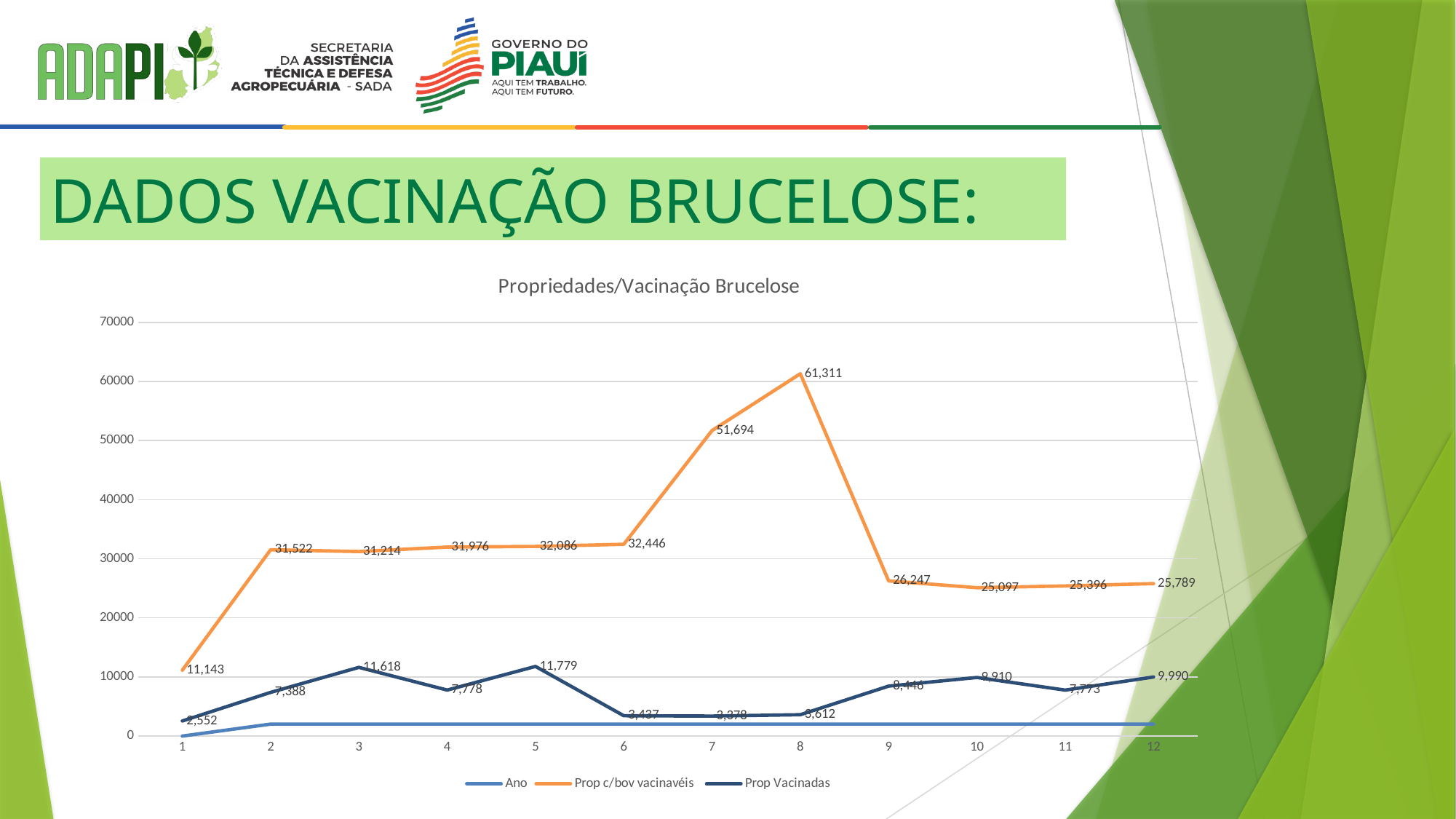
At which x-axis point is Prop c/bov vacinavéis highest? 8 What is the value of Prop Vacinadas at point 5? 11,779 What is the difference between Prop c/bov vacinavéis at point 8 and at point 7? 9,617 Is the value for Ano at point 6 greater or less than 10000? less What is the value of Prop Vacinadas at point 12? 9,990 How many points are plotted along the x axis for each series? 12 What is the title of the chart? Propriedades/Vacinação Brucelose Which is larger for Prop Vacinadas: the value at point 2 or at point 4? point 4 What is the value of Prop c/bov vacinavéis at point 8? 61,311 At which x-axis point is Prop c/bov vacinavéis lowest? 1 How many series does the legend list? 3 What kind of chart is shown on the slide? line chart